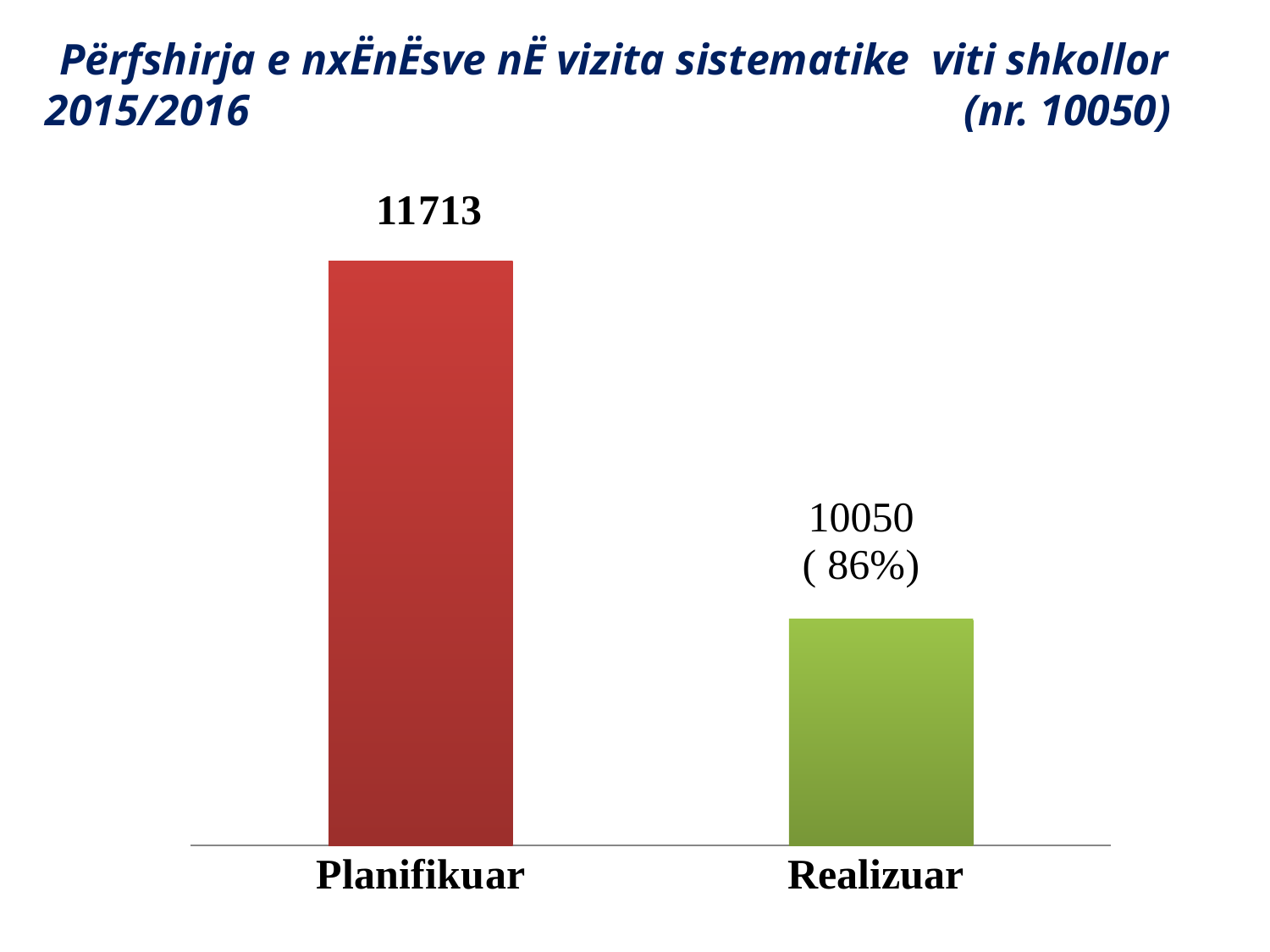
What kind of chart is shown on the slide? Bar chart Which category has the highest value? Planifikuar What colour is the Realizuar bar? Green What is the value for Planifikuar? 11713 What colour is the Planifikuar bar? Red How many categories are shown on the chart? 2 What is the value for Realizuar? 10050 What is the difference between the Planifikuar and Realizuar values? 1663 Which category has the lowest value? Realizuar Which is larger, Planifikuar or Realizuar? Planifikuar What percentage is shown next to the Realizuar bar? 86%